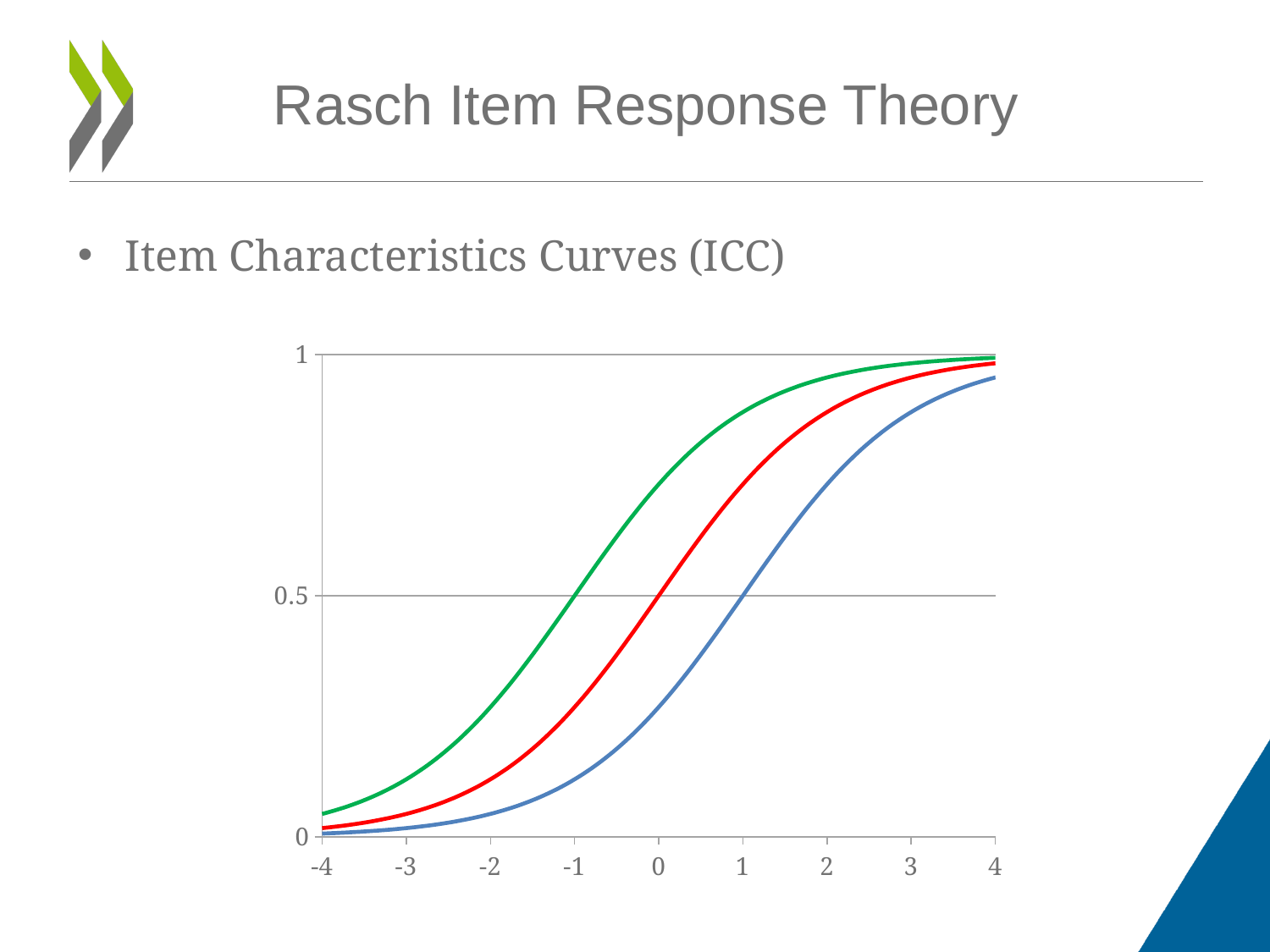
At x = 1, is the value of the green curve greater or less than 0.5? greater At x = 0, which curve has the lowest value? blue Do the curves rise or fall as the x axis goes from -4 to 4? rise At what x value does the red curve cross 0.5? 0 At x = 0, is the value of the green curve greater or less than 0.5? greater At x = -2, which is larger, the green curve or the blue curve? green At x = 0, is the value of the blue curve greater or less than 0.5? less How many curves are plotted on the chart? 3 At x = 0, which curve has the highest value? green What is the range of the x axis on the chart? -4 to 4 What kind of chart is shown on the slide? line chart